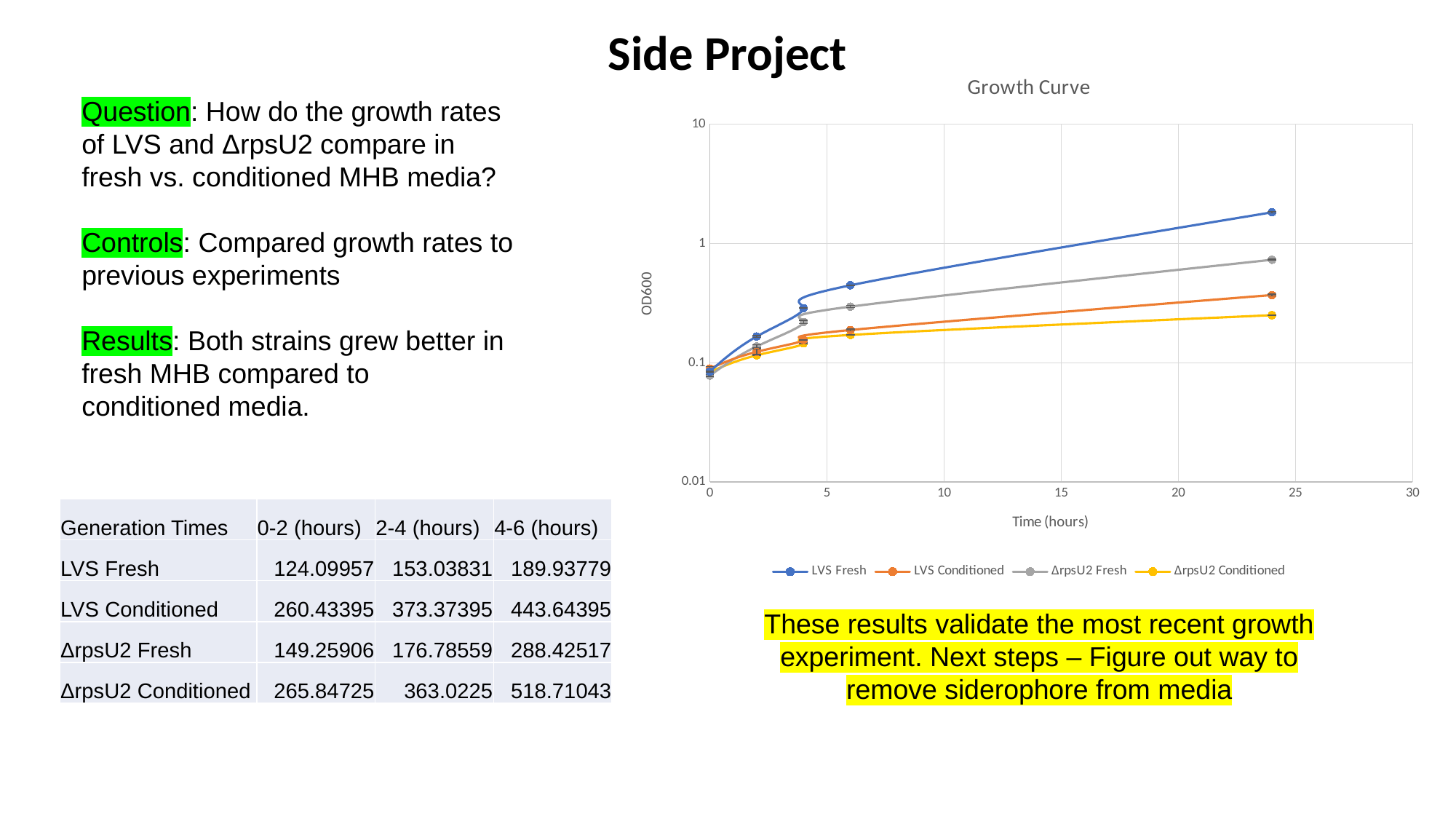
What is the label of the y axis on the Growth Curve chart? OD600 In the Growth Curve chart, at 24 hours, which is larger: the OD600 for ΔrpsU2 Fresh or for LVS Conditioned? ΔrpsU2 Fresh What kind of chart is the Growth Curve chart? line chart What is the title of the chart on the slide? Growth Curve In the Growth Curve chart, which series has the lowest OD600 at 24 hours? ΔrpsU2 Conditioned In the Growth Curve chart, does the OD600 for LVS Fresh rise or fall as time increases? rise How many series does the legend of the Growth Curve chart list? 4 In the Growth Curve chart, is the OD600 value for ΔrpsU2 Conditioned at 24 hours greater or less than 1? less In the Growth Curve chart, is the OD600 value for LVS Fresh at 6 hours greater or less than 1? less How many time points are plotted for each series in the Growth Curve chart? 5 In the Growth Curve chart, is the OD600 value for LVS Fresh at 24 hours greater or less than 1? greater In the Growth Curve chart, which series has the highest OD600 at 24 hours? LVS Fresh